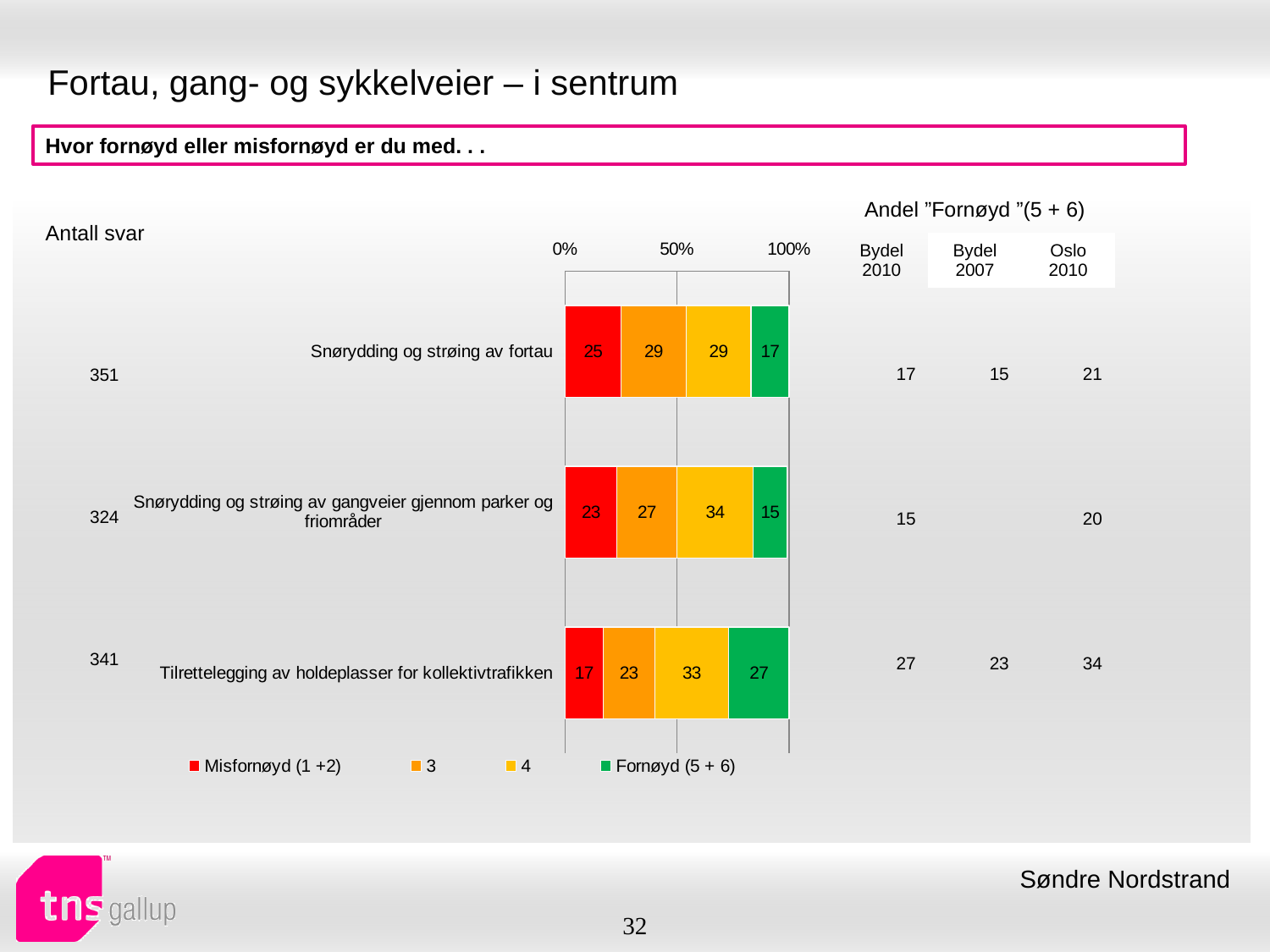
How many series does the chart legend list? 4 What is the value of the Misfornøyd (1 +2) segment for 'Snørydding og strøing av fortau'? 25 Which category has the highest Fornøyd (5 + 6) value? Tilrettelegging av holdeplasser for kollektivtrafikken How many categories are plotted in the chart? 3 Which is larger: the '3' segment for 'Snørydding og strøing av fortau' or the '3' segment for 'Tilrettelegging av holdeplasser for kollektivtrafikken'? Snørydding og strøing av fortau What is the total of the stacked bar for 'Snørydding og strøing av gangveier gjennom parker og friområder'? 99 What kind of chart is shown on the slide? stacked bar chart What colour represents the Fornøyd (5 + 6) series in the chart? green Which category has the lowest Fornøyd (5 + 6) value? Snørydding og strøing av gangveier gjennom parker og friområder What is the difference between the Misfornøyd (1 +2) values for 'Snørydding og strøing av fortau' and 'Tilrettelegging av holdeplasser for kollektivtrafikken'? 8 What is the value of the '4' segment for 'Snørydding og strøing av gangveier gjennom parker og friområder'? 34 What is the value of the Fornøyd (5 + 6) segment for 'Tilrettelegging av holdeplasser for kollektivtrafikken'? 27